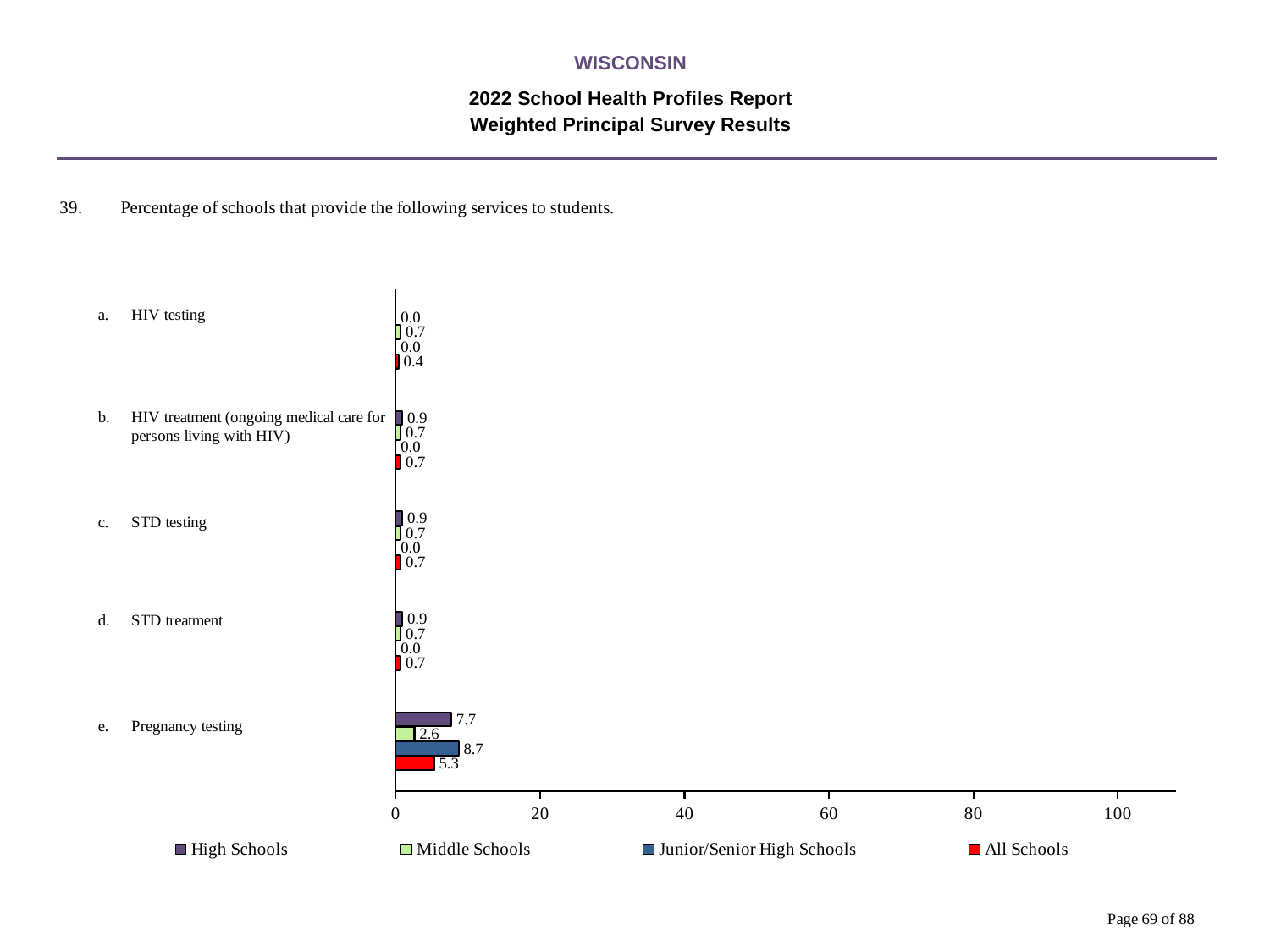
What is the value for High Schools for HIV testing? 0.0 What is the value for Middle Schools for STD treatment? 0.7 What kind of chart is shown on the slide? bar chart How many series does the legend list? 4 Which school type has the lowest value for Pregnancy testing? Middle Schools For Pregnancy testing, which is larger: the High Schools value or the All Schools value? High Schools Is the value for Junior/Senior High Schools for Pregnancy testing greater or less than 20? less How many services are listed on the chart? 5 What is the difference between the Junior/Senior High Schools and High Schools values for Pregnancy testing? 1.0 Which service has the highest value for All Schools? Pregnancy testing What is the value for Junior/Senior High Schools for Pregnancy testing? 8.7 What is the value for All Schools for HIV testing? 0.4